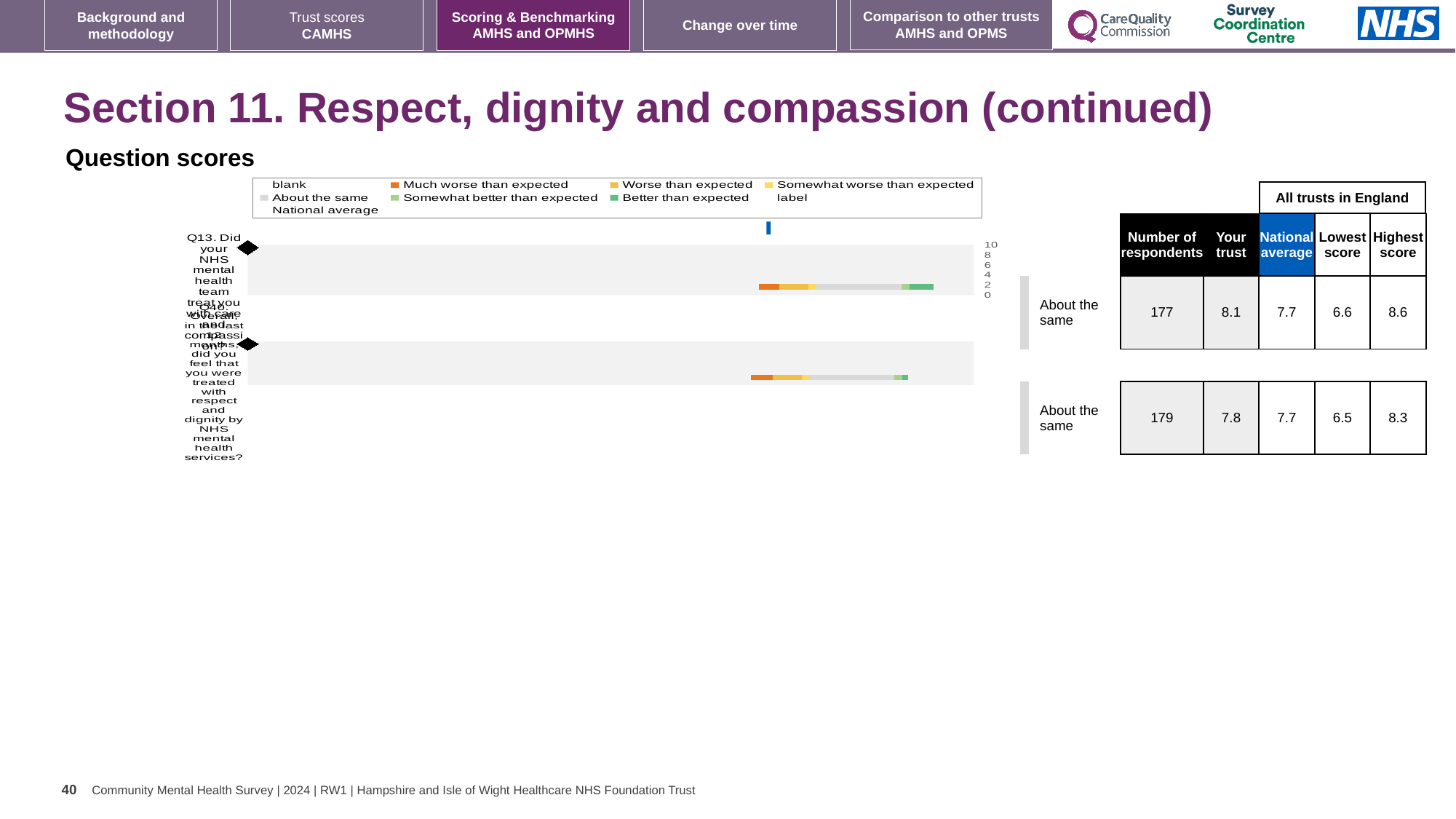
How many questions (categories) are plotted in the Question scores chart? 2 What is the difference between the 'Your trust' scores for Q13 and Q10 in the table beside the chart? 0.3 In the legend of the Question scores chart, what colour represents 'Better than expected'? green What benchmark category is shown for Q13 next to the chart? About the same According to the table beside the chart, what is the highest score for Q10? 8.3 Which question has the lower 'Lowest score' in the table beside the chart, Q13 or Q10? Q10 According to the table beside the chart, how many respondents answered Q10? 179 How many entries does the legend of the Question scores chart list? 9 According to the table beside the chart, what is the 'Your trust' score for Q13? 8.1 According to the table beside the chart, what is the national average for Q13? 7.7 Which question has the higher 'Your trust' score in the table beside the chart, Q13 or Q10? Q13 What kind of chart is shown under 'Question scores'? bar chart